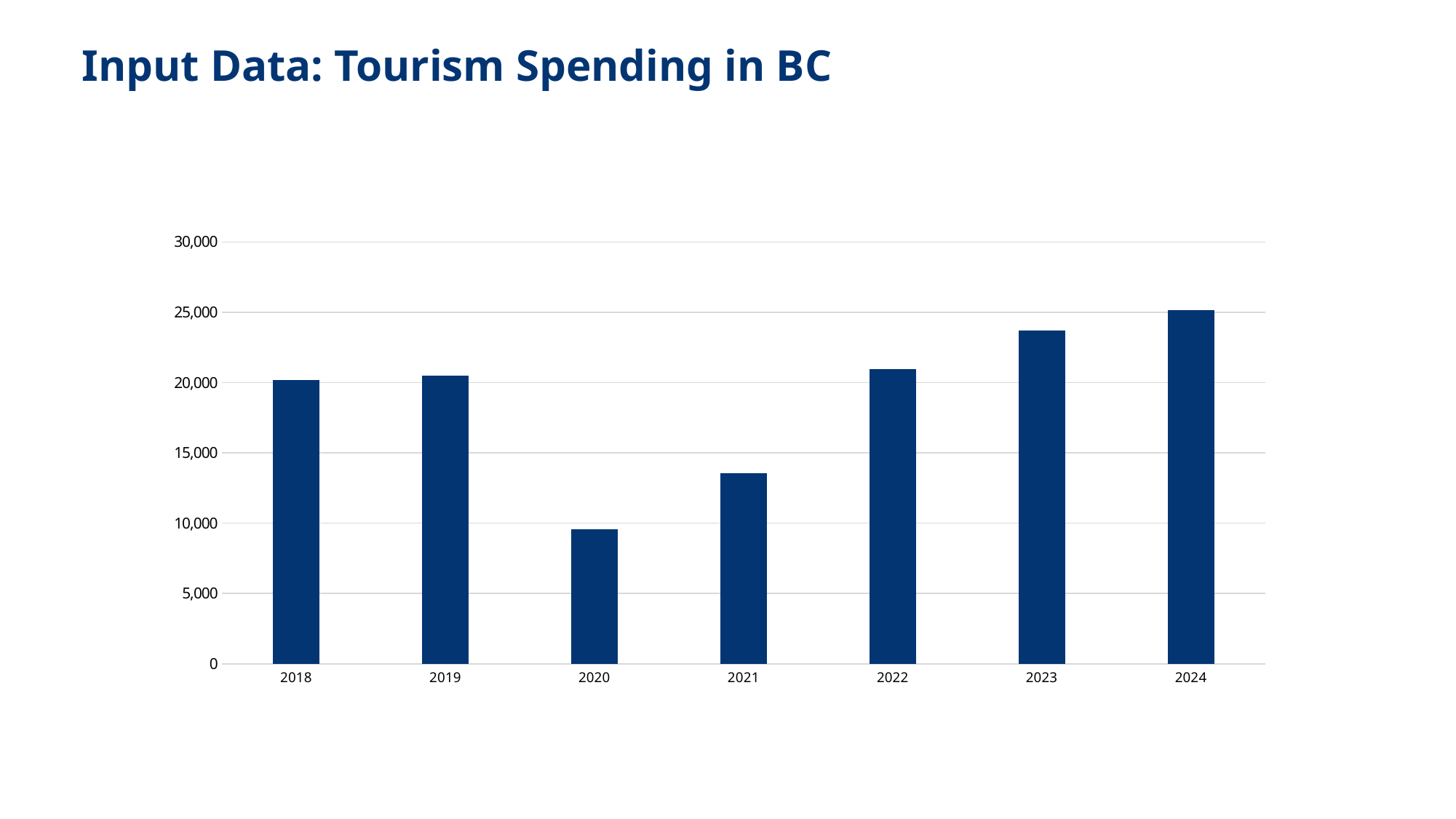
Is the value for 2020 greater or less than 5,000? greater Which is larger, the value for 2020 or the value for 2022? 2022 Is the value for 2022 greater or less than 20,000? greater How many years are shown on the x axis of the chart? 7 What is the title of the slide? Input Data: Tourism Spending in BC What kind of chart is shown on the slide? bar chart Do the values rise or fall from 2020 to 2024? rise Which is larger, the value for 2023 or the value for 2021? 2023 Is the value for 2021 greater or less than 15,000? less Which year has the lowest tourism spending in the chart? 2020 Which year has the highest tourism spending in the chart? 2024